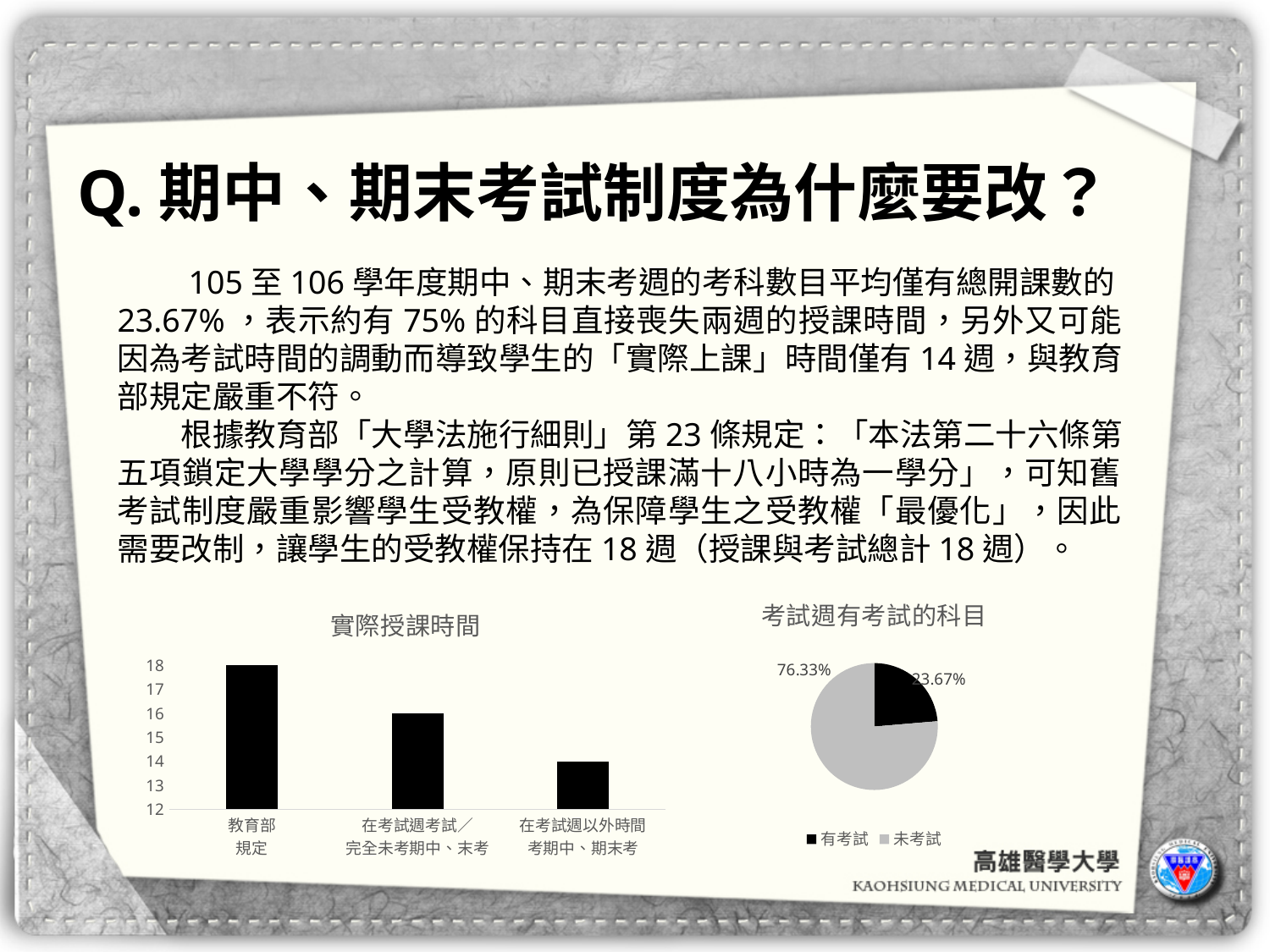
In the chart titled 實際授課時間, which category has the highest value? 教育部規定 In the chart titled 實際授課時間, which category has the lowest value? 在考試週以外時間考期中、期末考 In the chart titled 考試週有考試的科目, how many entries does the legend list? 2 What kind of chart is the chart titled 考試週有考試的科目? pie chart In the chart titled 實際授課時間, do the values rise or fall from left to right? fall What kind of chart is the chart titled 實際授課時間? bar chart In the chart titled 實際授課時間, what is the value for 教育部規定? 18 In the chart titled 實際授課時間, what is the difference between the values for 教育部規定 and 在考試週考試／完全未考期中、末考? 2 In the chart titled 考試週有考試的科目, what share of the pie is 有考試? 23.67% In the chart titled 考試週有考試的科目, what is the value for 未考試? 76.33% In the chart titled 實際授課時間, what is the value for 在考試週以外時間考期中、期末考? 14 In the chart titled 實際授課時間, how many categories are shown? 3